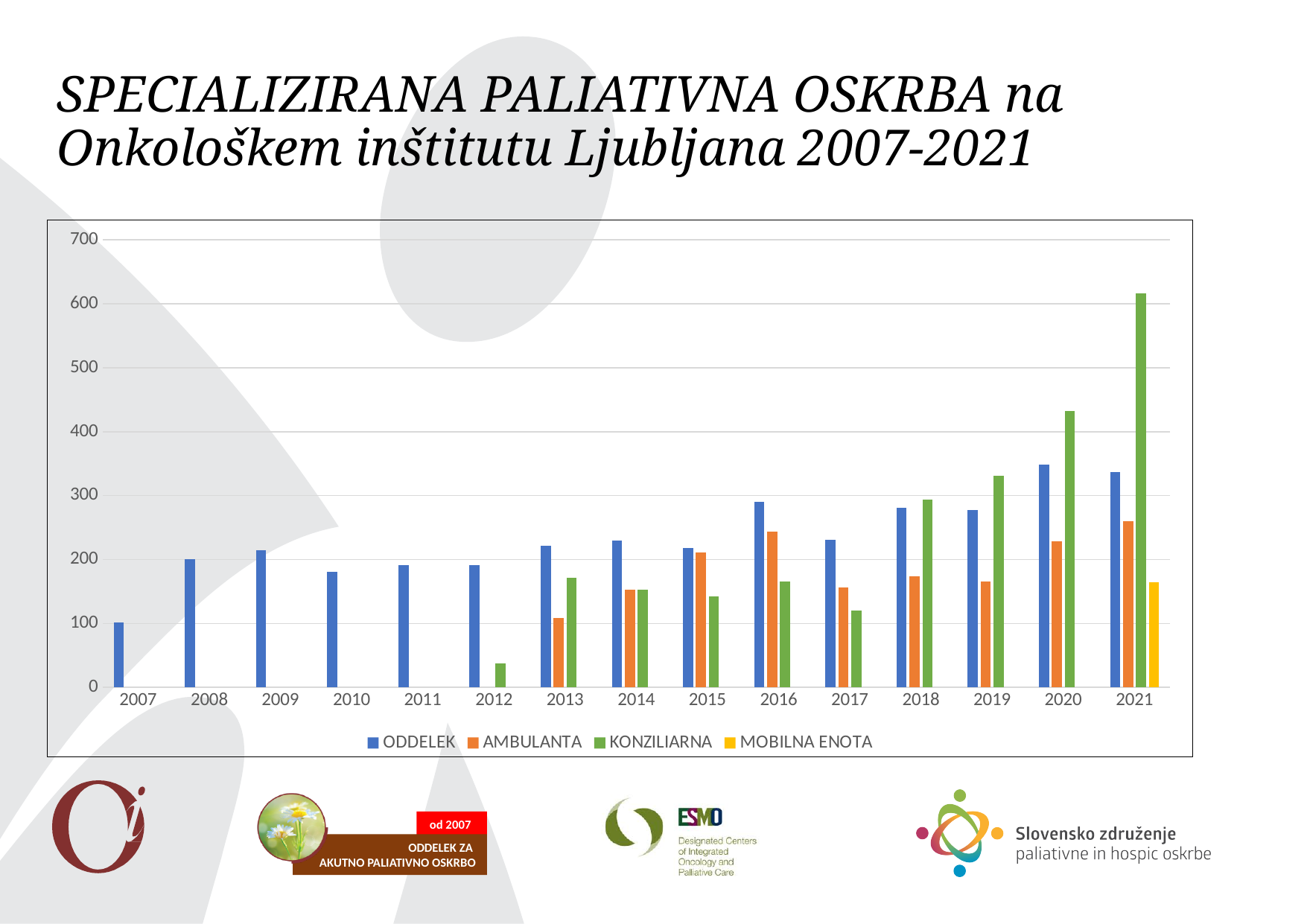
Is the ODDELEK value for 2010 greater or less than 200? less In 2016, which is larger: the AMBULANTA value or the KONZILIARNA value? AMBULANTA What kind of chart is shown on the slide? bar chart Is the KONZILIARNA value for 2020 greater or less than 400? greater Is the MOBILNA ENOTA value for 2021 greater or less than 200? less In which year is the KONZILIARNA value highest? 2021 In which year is the ODDELEK value lowest? 2007 How many years are shown on the x axis? 15 Which series is shown in yellow in the legend? MOBILNA ENOTA In 2021, which is larger: the ODDELEK value or the KONZILIARNA value? KONZILIARNA How many series does the legend list? 4